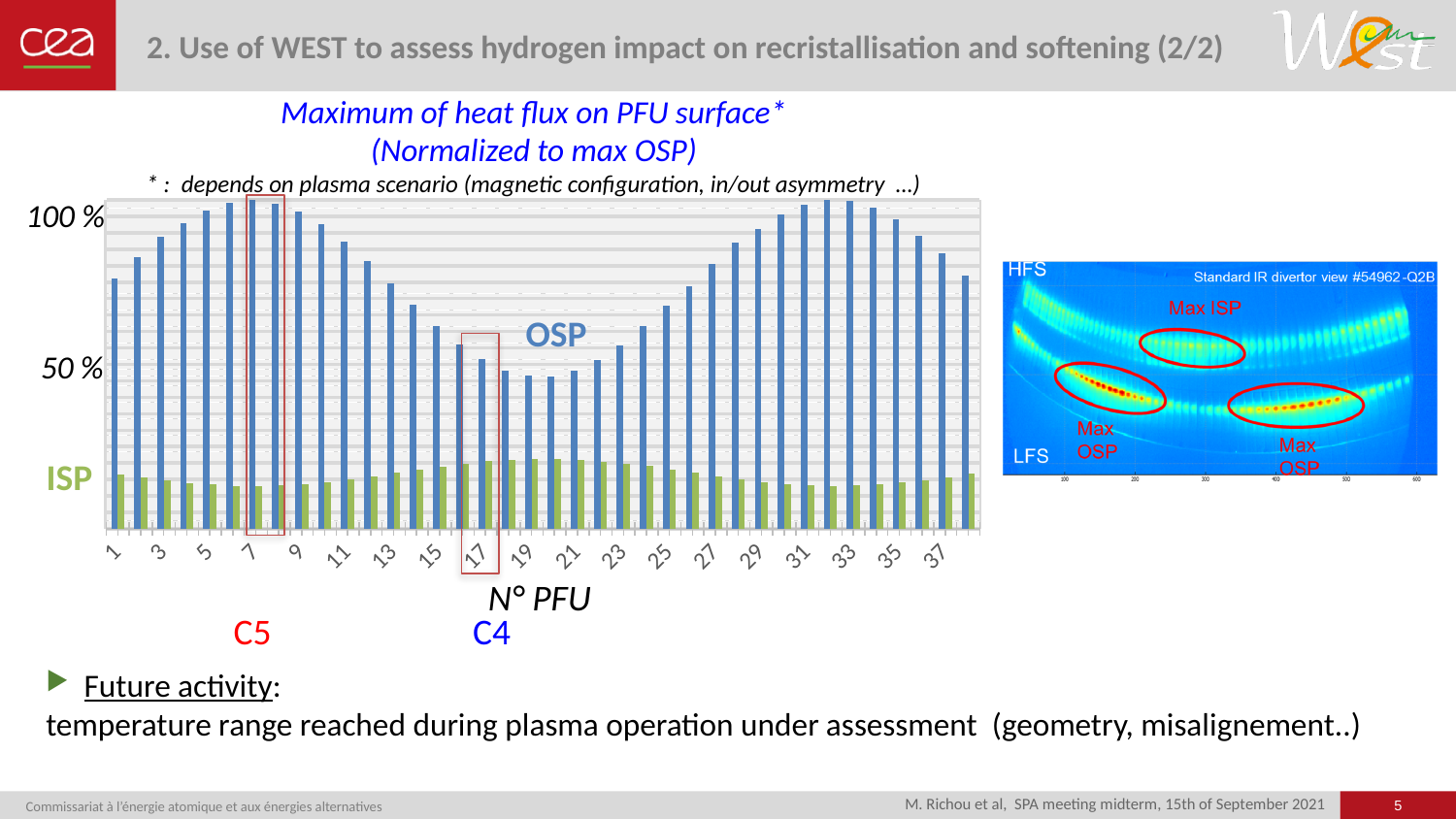
Do the OSP values rise or fall from PFU 7 to PFU 19? fall Is the OSP value for PFU 7 greater or less than 50 %? greater What kind of chart is shown on the slide? bar chart Is the ISP value for PFU 17 greater or less than 50 %? less Do the OSP values rise or fall from PFU 19 to PFU 33? rise At PFU 7, which series has the larger value, OSP or ISP? OSP How many data series are plotted in the chart? 2 Is the OSP value for PFU 13 greater or less than 50 %? greater What is the label of the x axis of the chart? N° PFU What is the title of the chart? Maximum of heat flux on PFU surface*